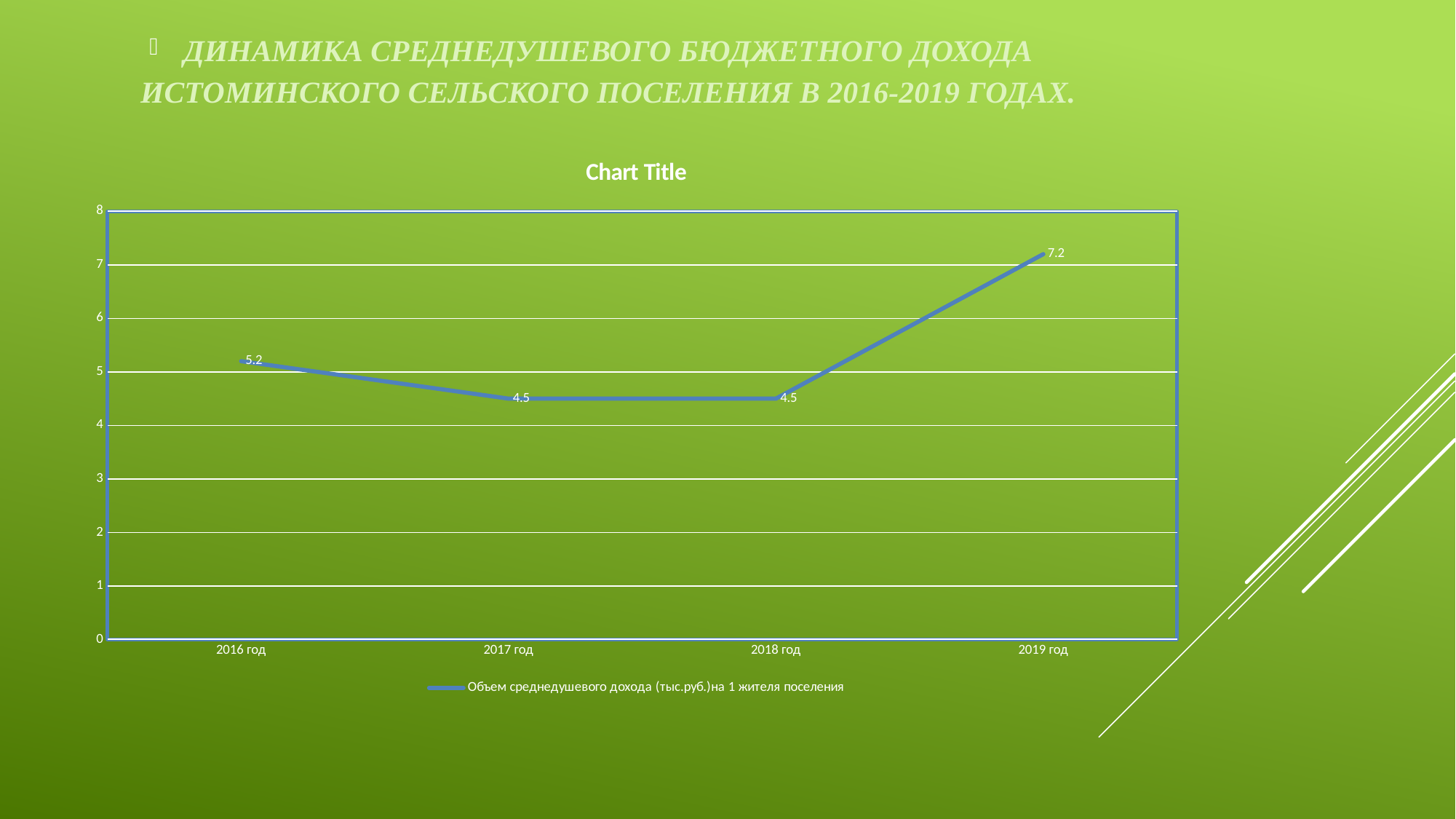
What kind of chart is shown? line chart Which year has the highest value? 2019 год What is the value for 2017 год? 4.5 What is the value for 2019 год? 7.2 Is the value for 2019 год greater or less than 7? greater What is the value for 2016 год? 5.2 What is the difference between the values for 2019 год and 2016 год? 2 How many series does the legend list? 1 What is the difference between the values for 2016 год and 2018 год? 0.7 Which is larger, the value for 2016 год or the value for 2017 год? 2016 год What is the title shown above the chart? Chart Title How many years are plotted on the x axis? 4